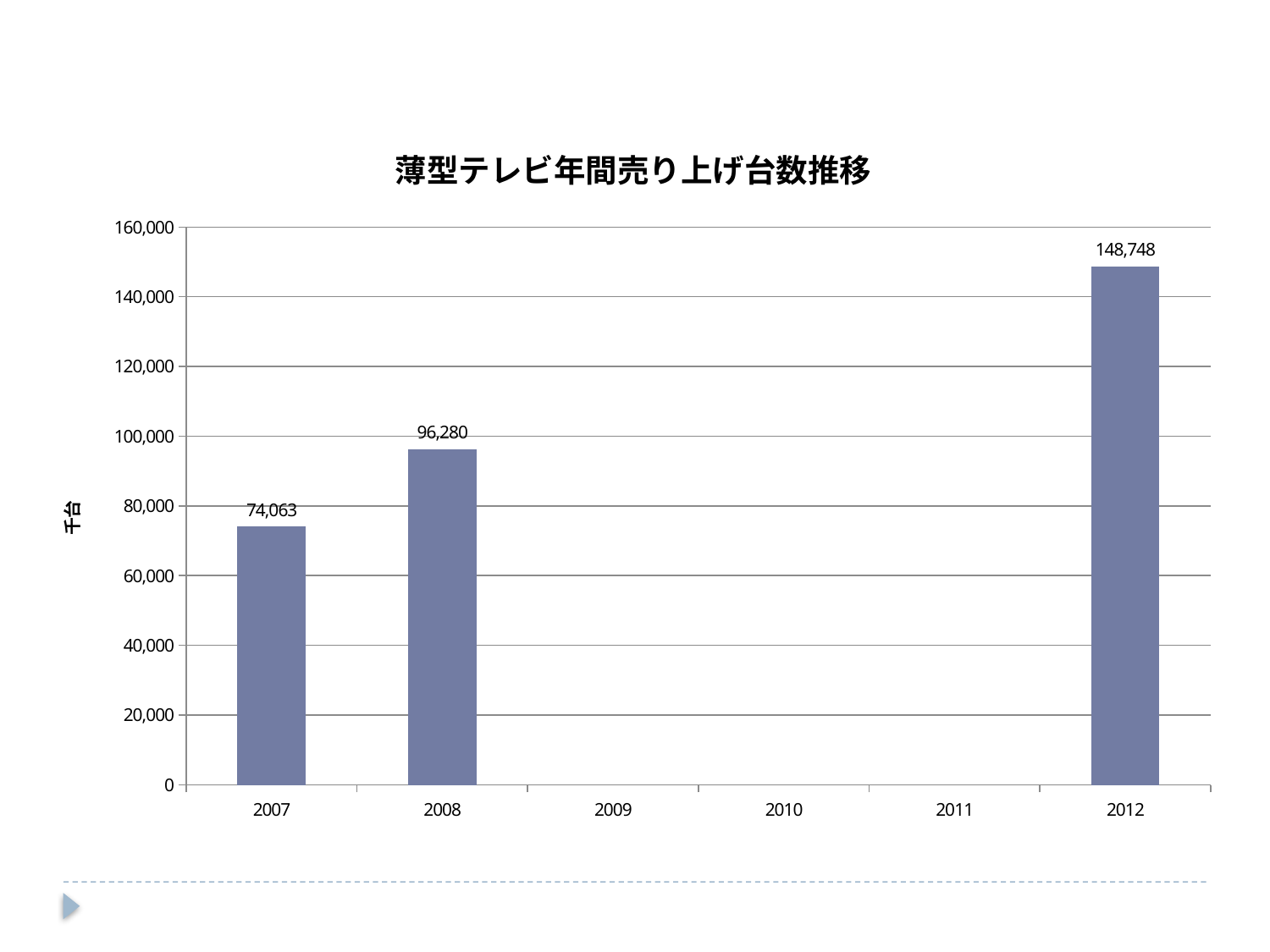
What is the difference between the values for 2008 and 2007? 22,217 Is the value for 2008 greater or less than 100,000? less What is the title of the chart? 薄型テレビ年間売り上げ台数推移 What is the value for 2012? 148,748 Among the years with a bar shown, which has the lowest value? 2007 Which is larger, the value for 2008 or the value for 2012? 2012 Which year has the highest value? 2012 How many years are labelled on the x axis? 6 What is the difference between the values for 2012 and 2007? 74,685 What kind of chart is shown? bar chart What is the value for 2008? 96,280 What is the value for 2007? 74,063